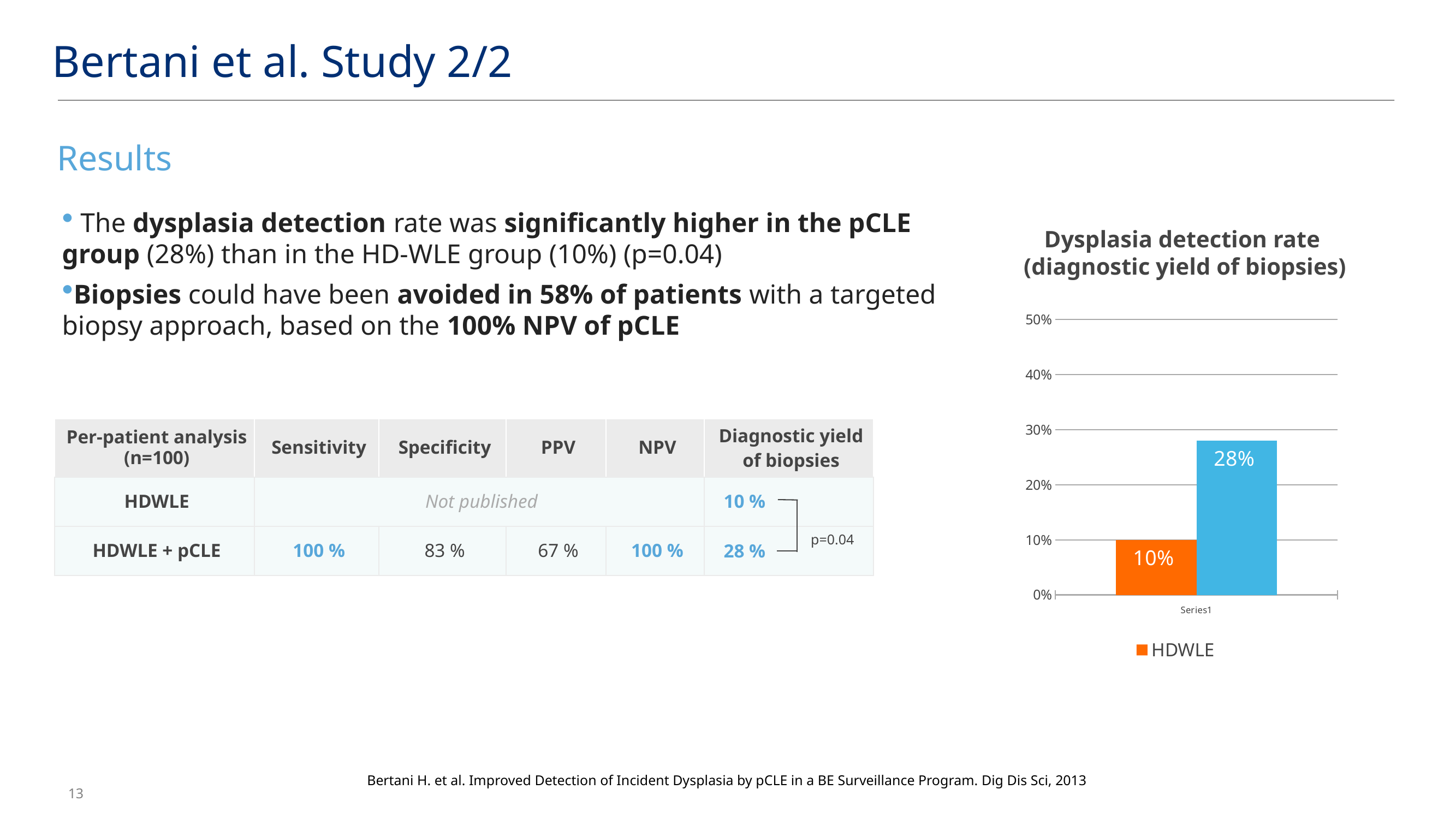
Is the value of the blue bar greater or less than 20%? greater What is the lowest value shown in the chart? 10% How many entries does the chart legend list? 1 What is the difference between the blue bar (28%) and the HDWLE bar (10%)? 18% What is the value of the HDWLE bar in the chart? 10% What is the highest value shown in the chart? 28% What type of chart is shown on the slide? bar chart Is the value of the HDWLE bar greater or less than 20%? less How many bars are plotted in the chart? 2 What value is printed on the blue bar in the chart? 28% What is the title of the chart? Dysplasia detection rate (diagnostic yield of biopsies) Which bar is taller, the orange HDWLE bar or the blue bar? the blue bar